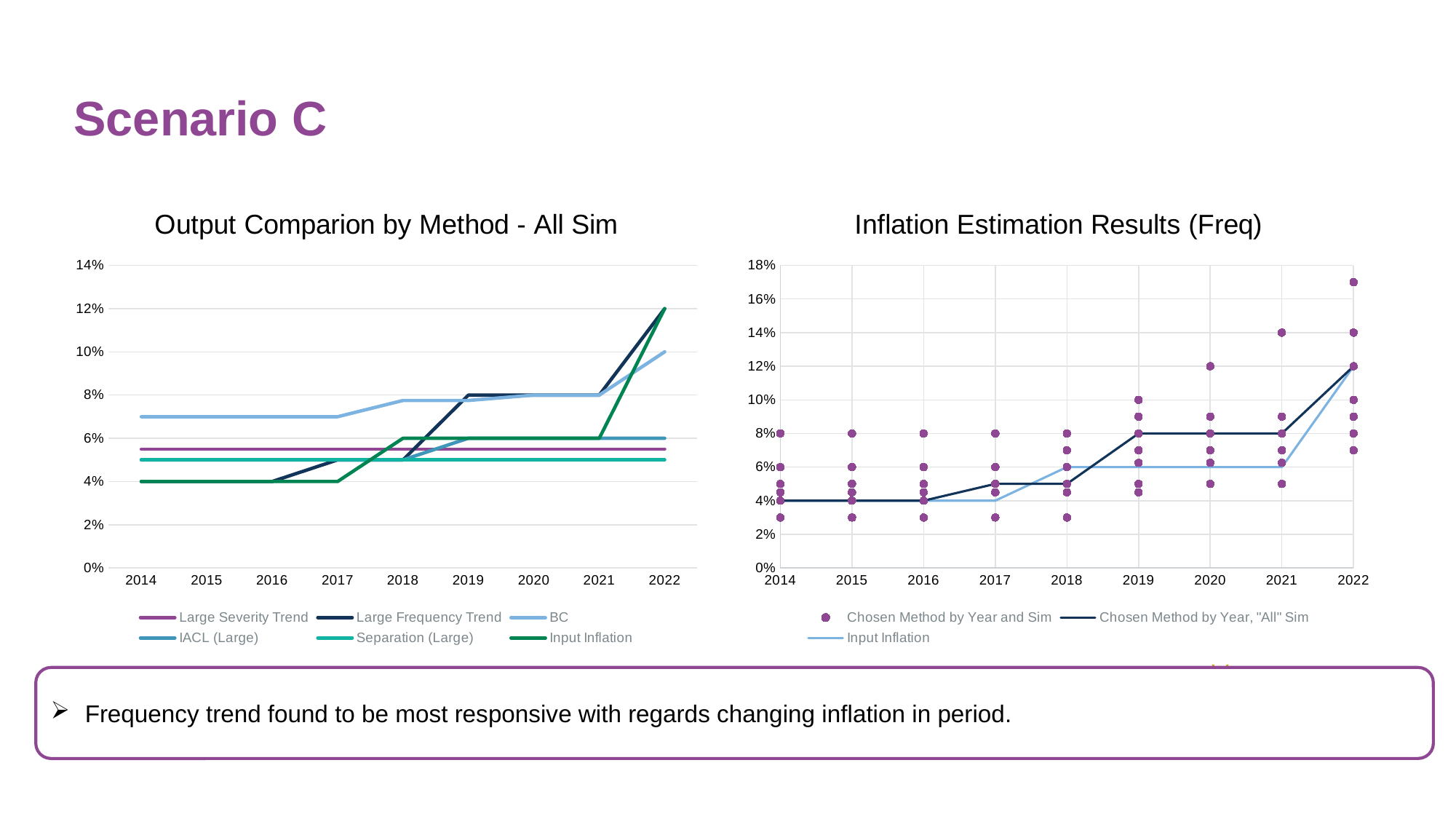
On the 'Inflation Estimation Results (Freq)' chart, how many series does the legend list? 3 On the 'Output Comparion by Method - All Sim' chart, which series has the highest value in 2014? BC On the 'Output Comparion by Method - All Sim' chart, how many series does the legend list? 6 On the 'Output Comparion by Method - All Sim' chart, what is the value of Large Frequency Trend in 2022? 12% What kind of chart is 'Output Comparion by Method - All Sim'? line chart On the 'Output Comparion by Method - All Sim' chart, what is the value of Input Inflation in 2014? 4% On the 'Inflation Estimation Results (Freq)' chart, what is the value of Input Inflation in 2022? 12% On the 'Output Comparion by Method - All Sim' chart, is the value for Large Severity Trend in 2014 greater or less than 6%? less On the 'Output Comparion by Method - All Sim' chart, what is the value of BC in 2022? 10% On the 'Output Comparion by Method - All Sim' chart, how many years are shown on the x axis? 9 On the 'Output Comparion by Method - All Sim' chart, does Input Inflation rise or fall from 2014 to 2022? rise On the 'Output Comparion by Method - All Sim' chart, what is the difference between Large Frequency Trend and BC in 2022? 2%